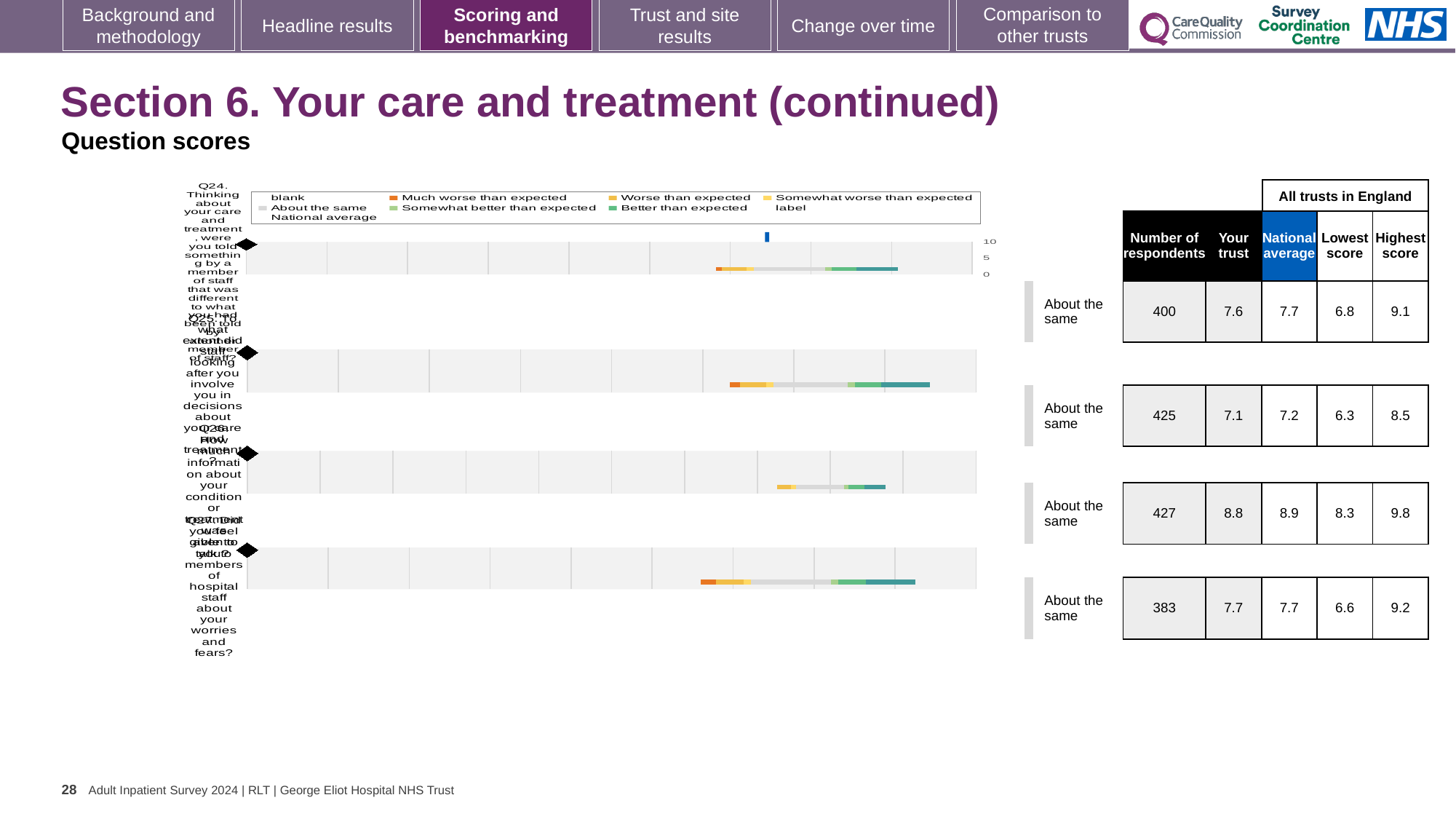
For the fourth (bottom) chart, Q27, what is the lowest score among all trusts in England? 6.6 What colour represents 'Much worse than expected' in the legend? Orange For the first (top) chart, Q24, what is the 'Your trust' score? 7.6 How many benchmarking charts are shown on the slide? 4 What kind of chart is used for each question on the slide? Bar chart Which chart has the lowest 'Your trust' score? The second chart, Q25 (7.1) For the first (top) chart, Q24, what is the national average score? 7.7 For the third chart, Q26, how many respondents are there? 427 For the third chart, Q26, what is the difference between the highest score and the lowest score? 1.5 In which benchmarking category does the trust's score fall for all four charts? About the same For the second chart, Q25, which is larger: the 'Your trust' score or the national average? National average (7.2) Which chart has the highest 'Your trust' score? The third chart, Q26 (8.8)